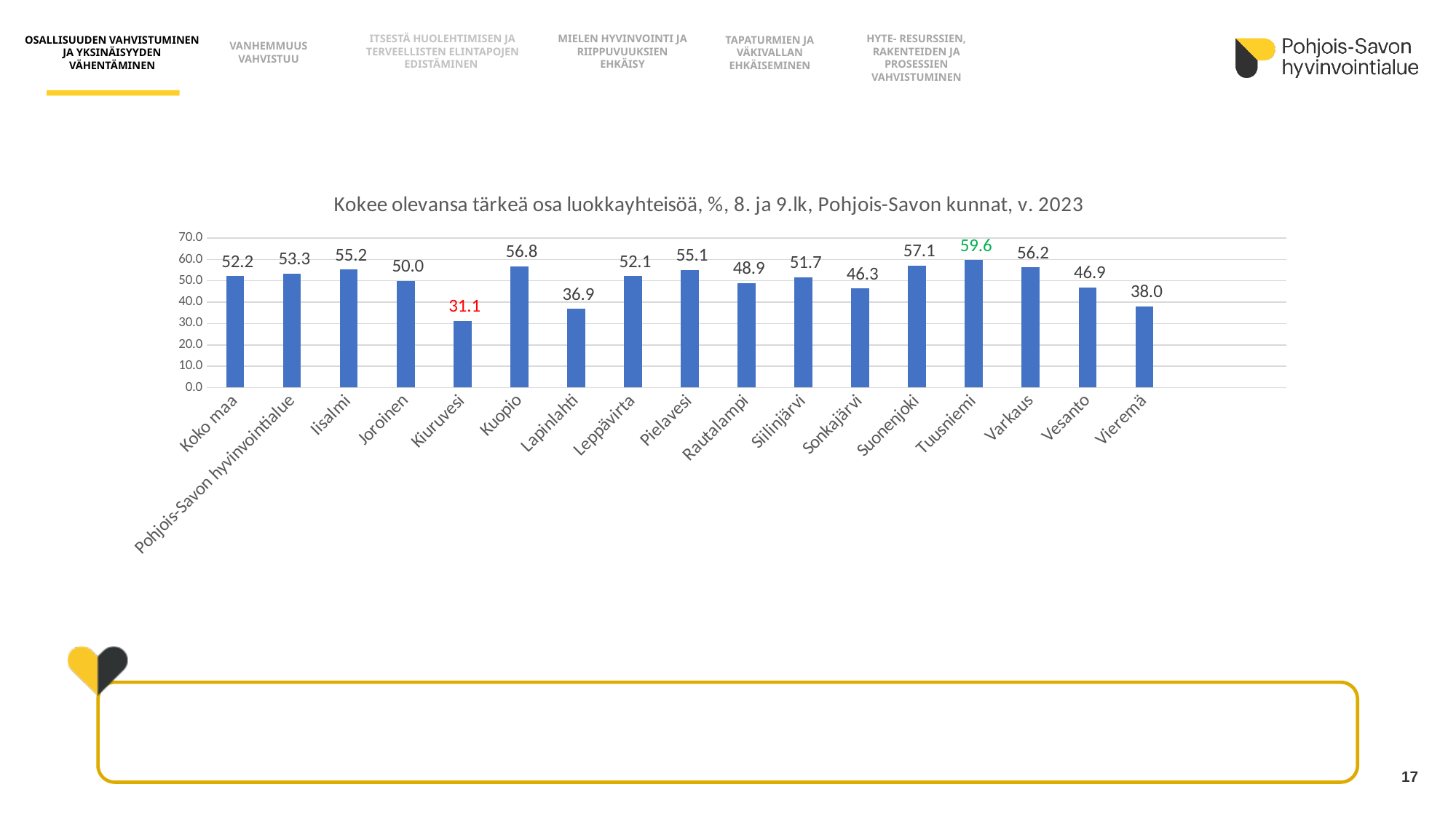
What is the value for Kuopio? 56.8 What is the difference between the values for Varkaus and Vesanto? 9.3 How many categories are shown on the x axis? 17 What is the title of the chart? Kokee olevansa tärkeä osa luokkayhteisöä, %, 8. ja 9.lk, Pohjois-Savon kunnat, v. 2023 Which category has the lowest value? Kiuruvesi What is the difference between the values for Tuusniemi and Kiuruvesi? 28.5 What kind of chart is shown on the slide? bar chart Is the value for Lapinlahti greater or less than 40.0? less What is the value for Koko maa? 52.2 Which category has the highest value? Tuusniemi What is the value for Pohjois-Savon hyvinvointialue? 53.3 Which is larger, the value for Iisalmi or the value for Pielavesi? Iisalmi